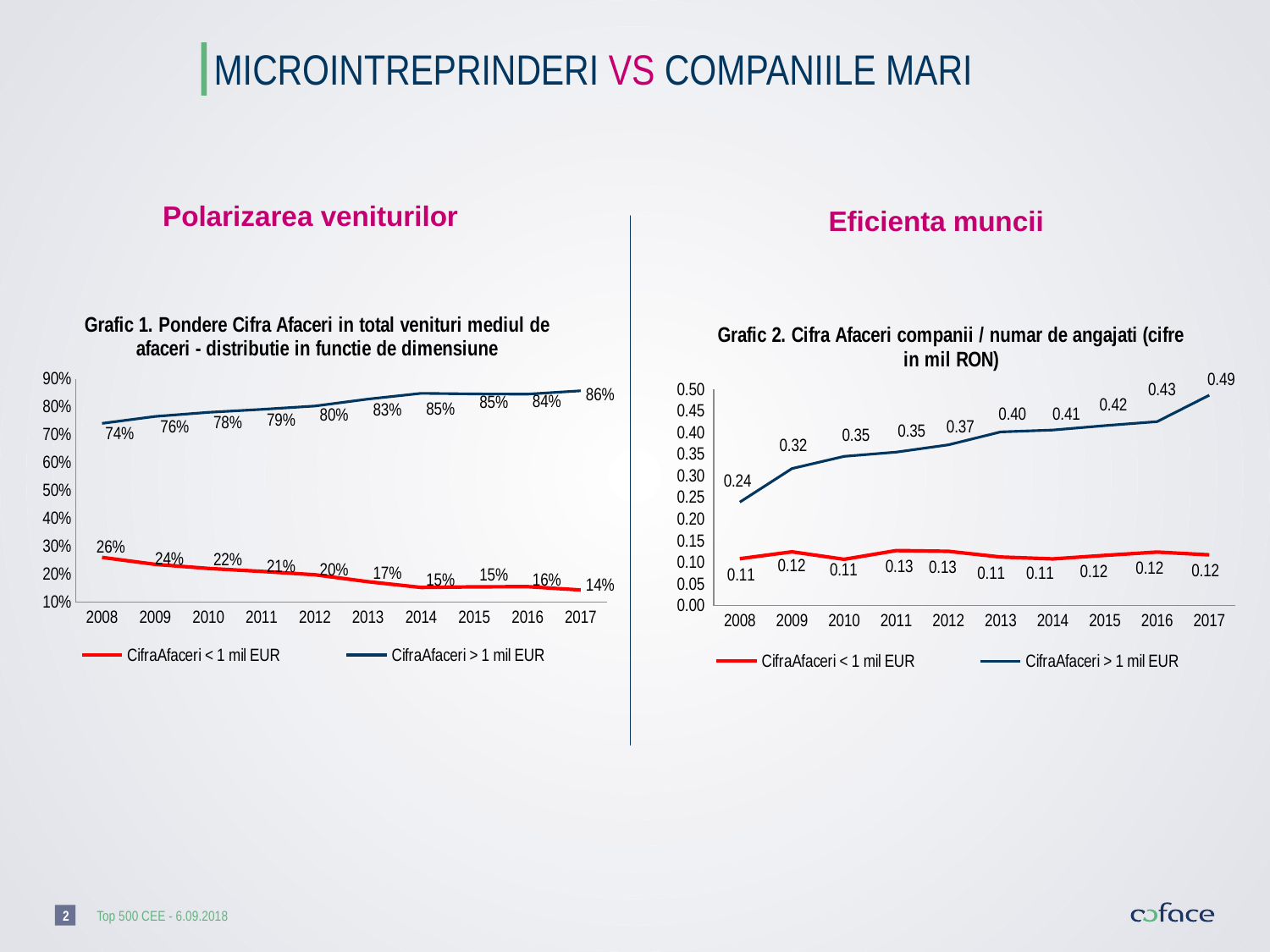
In Grafic 1 (left chart), does the CifraAfaceri > 1 mil EUR series generally rise or fall from 2008 to 2017? rise In Grafic 1 (left chart), what is the value for CifraAfaceri < 1 mil EUR in 2008? 26% In Grafic 1 (left chart), what is the value for CifraAfaceri > 1 mil EUR in 2017? 86% In Grafic 2 (right chart), which is larger in 2014: CifraAfaceri > 1 mil EUR or CifraAfaceri < 1 mil EUR? CifraAfaceri > 1 mil EUR In Grafic 1 (left chart), in which year is the CifraAfaceri < 1 mil EUR series lowest? 2017 In Grafic 1 (left chart), how many years are shown on the x axis? 10 In Grafic 2 (right chart), what is the difference between the CifraAfaceri > 1 mil EUR values in 2017 and 2008? 0.25 In Grafic 1 (left chart), what is the difference between the CifraAfaceri > 1 mil EUR and CifraAfaceri < 1 mil EUR values in 2013? 66% In Grafic 2 (right chart), what is the value for CifraAfaceri > 1 mil EUR in 2017? 0.49 In Grafic 2 (right chart), in which year is the CifraAfaceri > 1 mil EUR series lowest? 2008 In Grafic 2 (right chart), what is the value for CifraAfaceri < 1 mil EUR in 2011? 0.13 What type of chart is Grafic 2 (right chart)? line chart